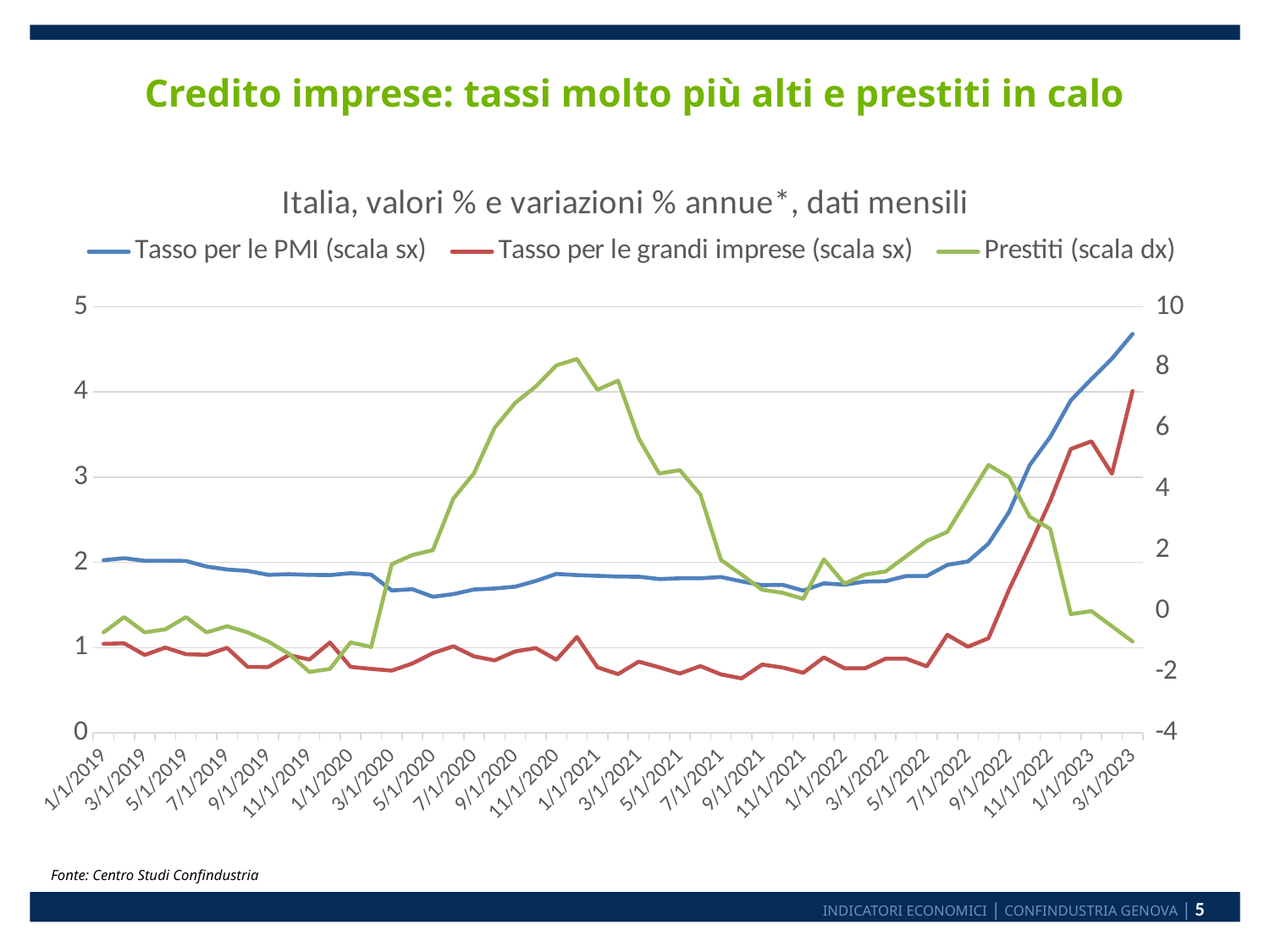
Is the value for Tasso per le PMI at 3/1/2023 greater or less than 4? greater Is the value for Tasso per le grandi imprese at 3/1/2023 greater or less than 3? greater Is the value for Prestiti at 11/1/2020 greater or less than 6 on the right-hand axis? greater What colour is the Prestiti (scala dx) line? green At 1/1/2019, which is higher: Tasso per le PMI or Tasso per le grandi imprese? Tasso per le PMI At 3/1/2023, which is higher: Tasso per le PMI or Tasso per le grandi imprese? Tasso per le PMI What kind of chart is shown on the slide? line chart Does the Tasso per le PMI line rise or fall between 1/1/2022 and 3/1/2023? rise How many series does the legend list? 3 Does the Prestiti line rise or fall between 11/1/2020 and 9/1/2021? fall